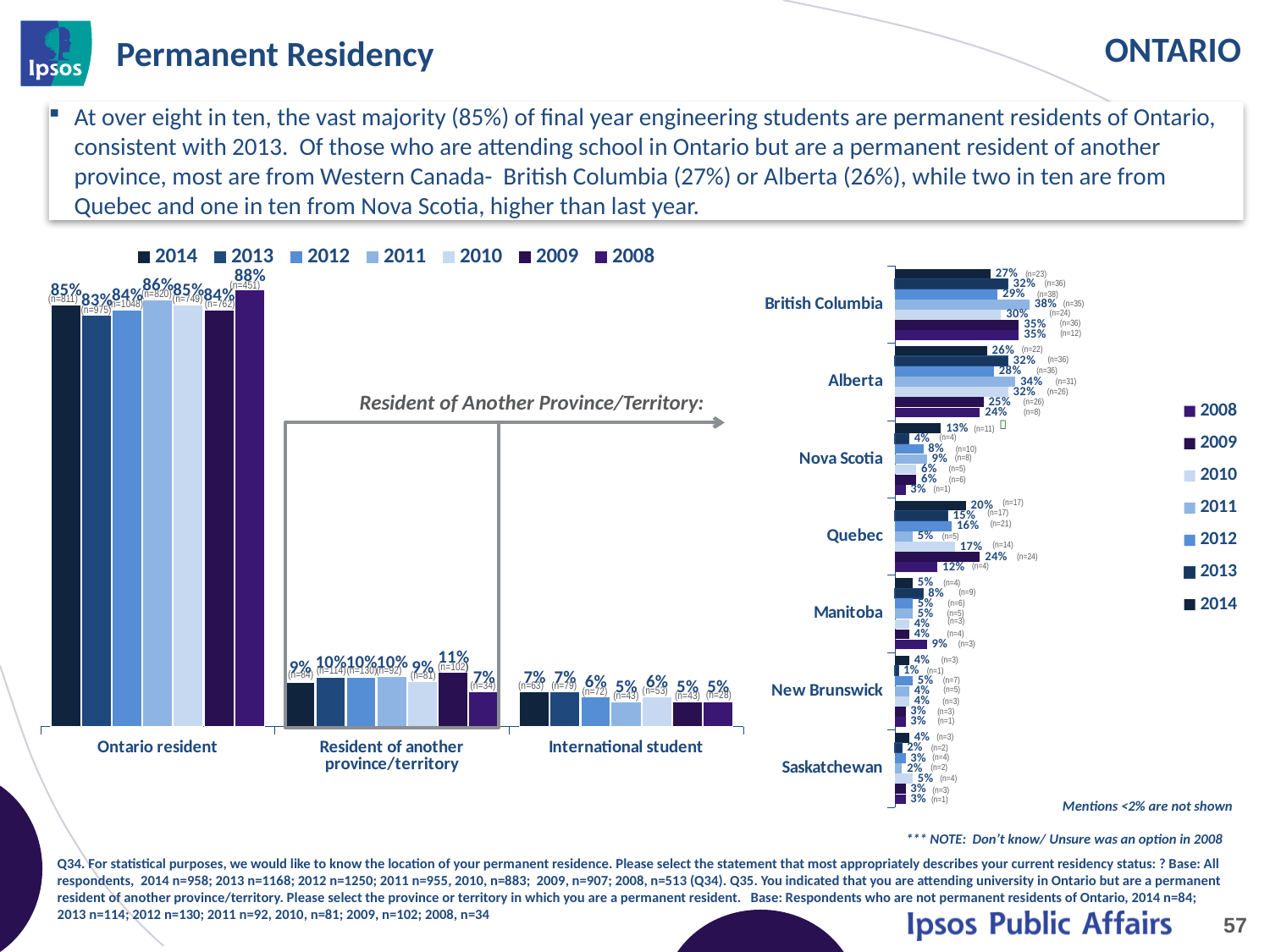
How many provinces are listed on the right chart? 7 What kind of chart is the right chart? Bar chart In the right chart, what is the 2014 value for Nova Scotia? 13% In the right chart, which province has the lowest 2014 value? New Brunswick and Saskatchewan (4%) In the right chart, is the 2014 value for Alberta larger or smaller than the 2014 value for Quebec? Larger In the left chart, what is the difference between the 2008 and 2014 values for Ontario resident? 3 percentage points In the left chart, what percentage of students were international students in 2013? 7% How many series does the legend of the left chart list? 7 How many categories are shown on the x axis of the left chart? 3 In the left chart, what percentage of students were Ontario residents in 2014? 85% In the left chart, which year had the highest share of Ontario residents? 2008 In the right chart, what is the 2014 value for British Columbia? 27%